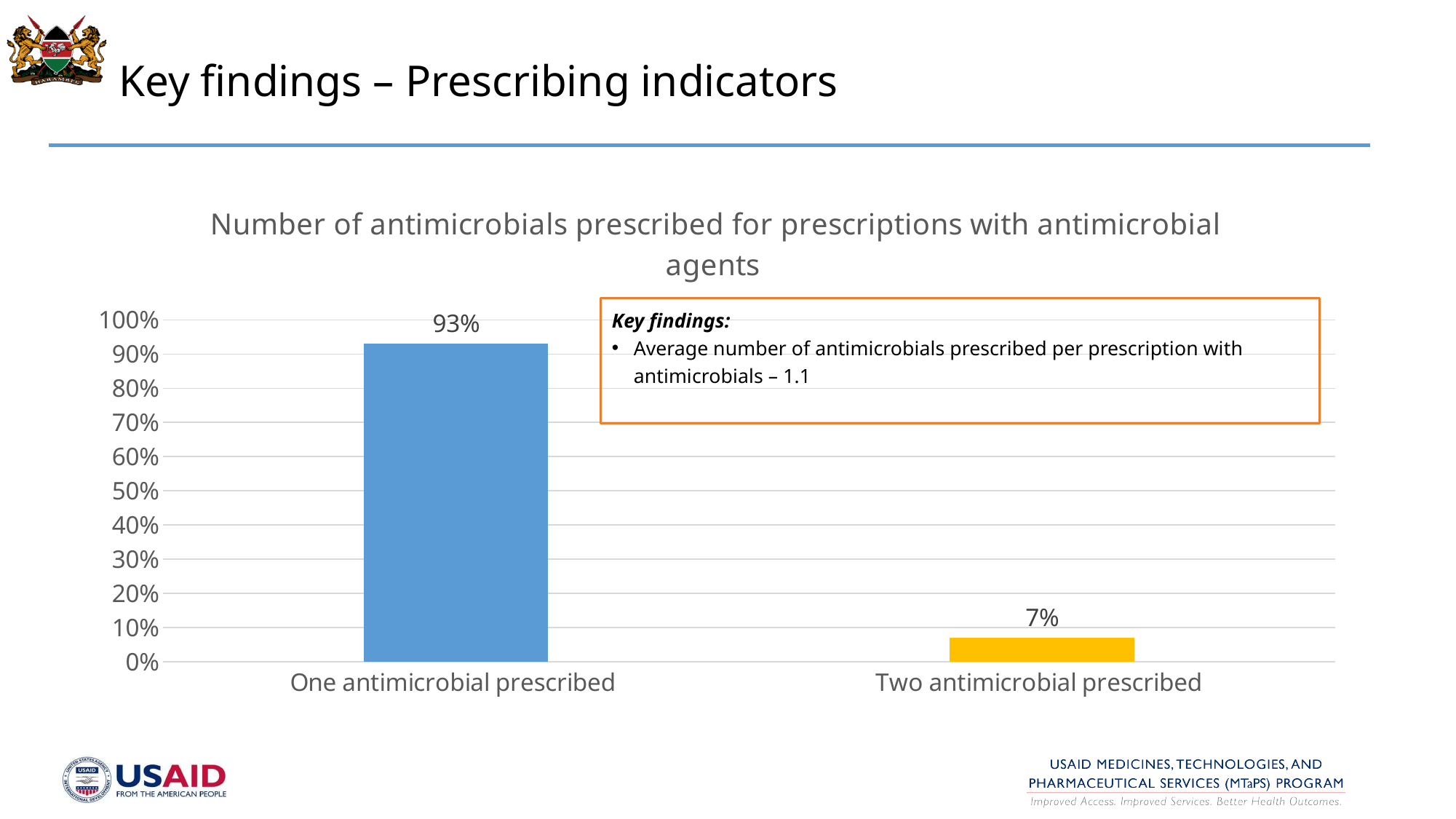
Which category has the lowest value? Two antimicrobial prescribed What is the value for 'Two antimicrobial prescribed'? 7% Which category has the highest value? One antimicrobial prescribed How many categories are shown on the x axis? 2 Is the value for 'Two antimicrobial prescribed' greater or less than 10%? less What kind of chart is shown on the slide? Bar chart Is the value for 'One antimicrobial prescribed' greater or less than 90%? greater What is the difference between the values for 'One antimicrobial prescribed' and 'Two antimicrobial prescribed'? 86% What is the value for 'One antimicrobial prescribed'? 93% What colour is the bar for 'Two antimicrobial prescribed'? Yellow Which is larger: the value for 'One antimicrobial prescribed' or 'Two antimicrobial prescribed'? One antimicrobial prescribed What is the title of the chart? Number of antimicrobials prescribed for prescriptions with antimicrobial agents